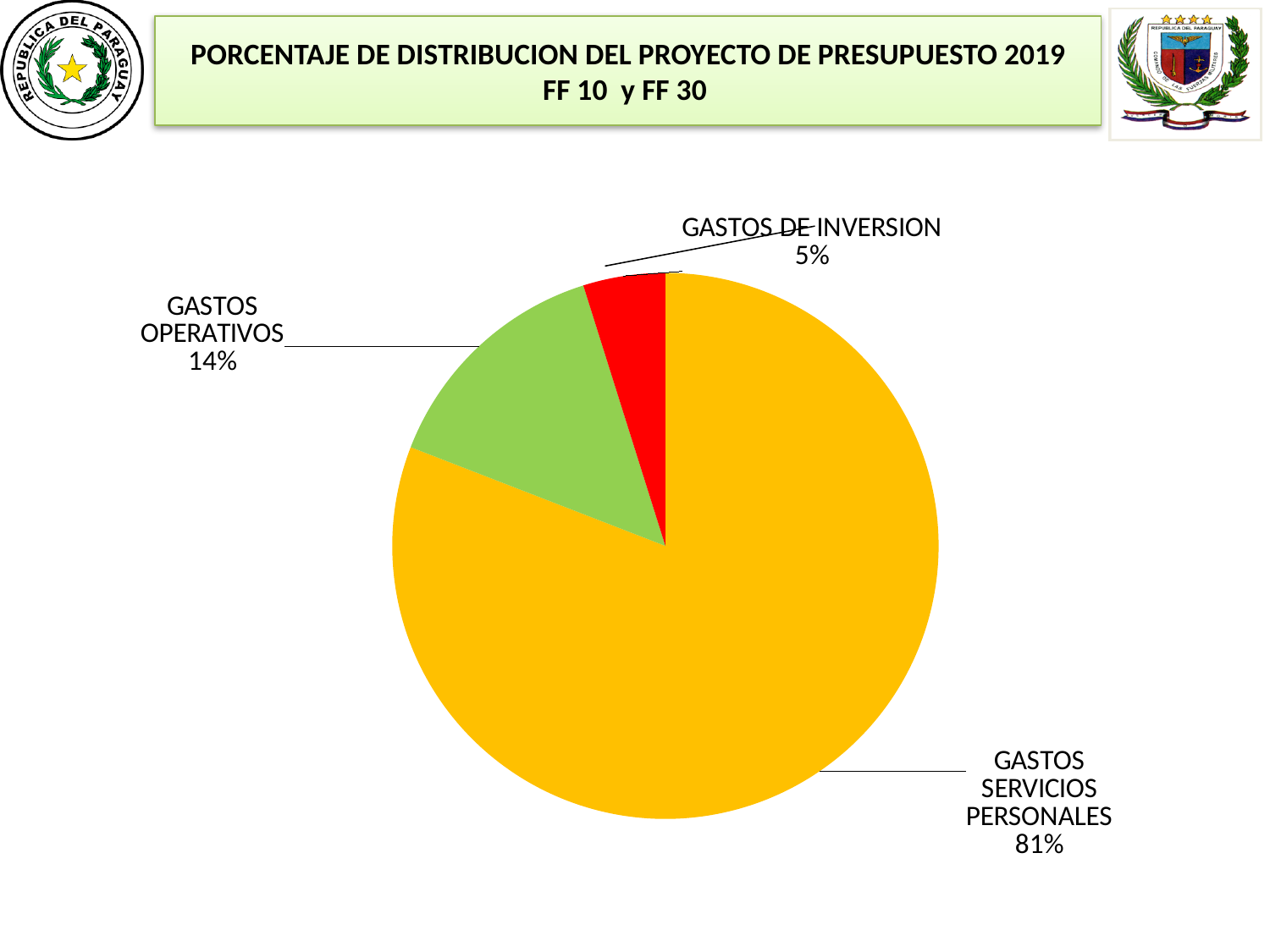
What percentage of the budget is GASTOS OPERATIVOS? 14% Which category has the smallest share of the pie? GASTOS DE INVERSION What colour is the GASTOS DE INVERSION slice? red How many slices does the pie chart have? 3 What kind of chart is shown on the slide? pie chart What colour is the GASTOS SERVICIOS PERSONALES slice? yellow Which category has the largest share of the pie? GASTOS SERVICIOS PERSONALES Which is larger, GASTOS OPERATIVOS or GASTOS DE INVERSION? GASTOS OPERATIVOS What is the difference in percentage points between GASTOS OPERATIVOS and GASTOS DE INVERSION? 9 What is the difference in percentage points between GASTOS SERVICIOS PERSONALES and GASTOS OPERATIVOS? 67 What percentage of the budget is GASTOS SERVICIOS PERSONALES? 81% What percentage of the budget is GASTOS DE INVERSION? 5%